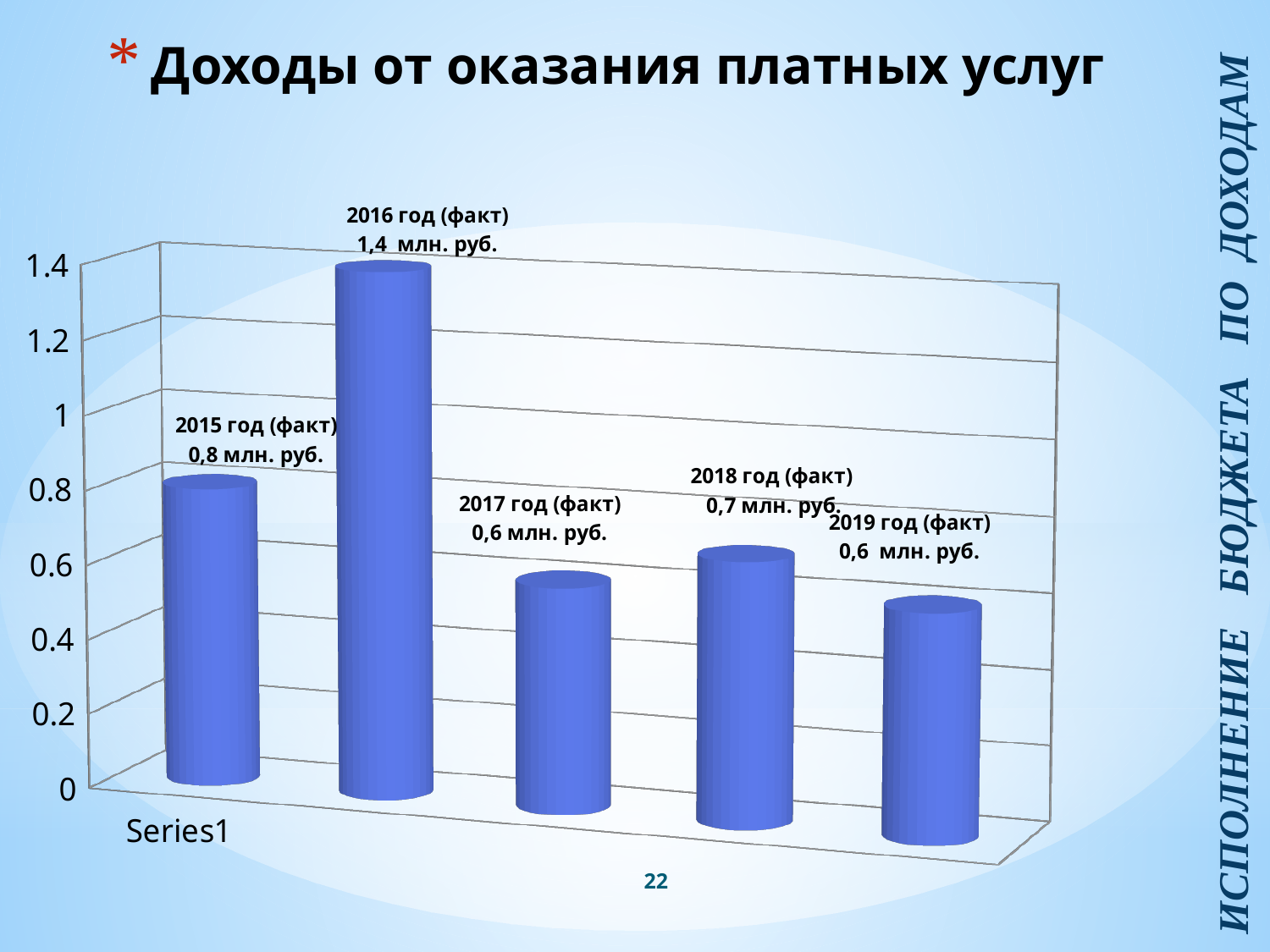
What is the difference between the values for 2016 год (факт) and 2015 год (факт)? 0,6 млн. руб. Which is larger, the value for 2015 год (факт) or 2018 год (факт)? 2015 год (факт) What is the value for 2016 год (факт)? 1,4 млн. руб. What is the value for 2019 год (факт)? 0,6 млн. руб. What is the value for 2018 год (факт)? 0,7 млн. руб. What is the title of the chart? Доходы от оказания платных услуг What kind of chart is shown on the slide? bar chart What is the value for 2015 год (факт)? 0,8 млн. руб. Is the value for 2016 год (факт) greater or less than 1? greater Which year has the highest income from paid services? 2016 год (факт) How many bars are shown in the chart? 5 What is the difference between the values for 2018 год (факт) and 2017 год (факт)? 0,1 млн. руб.